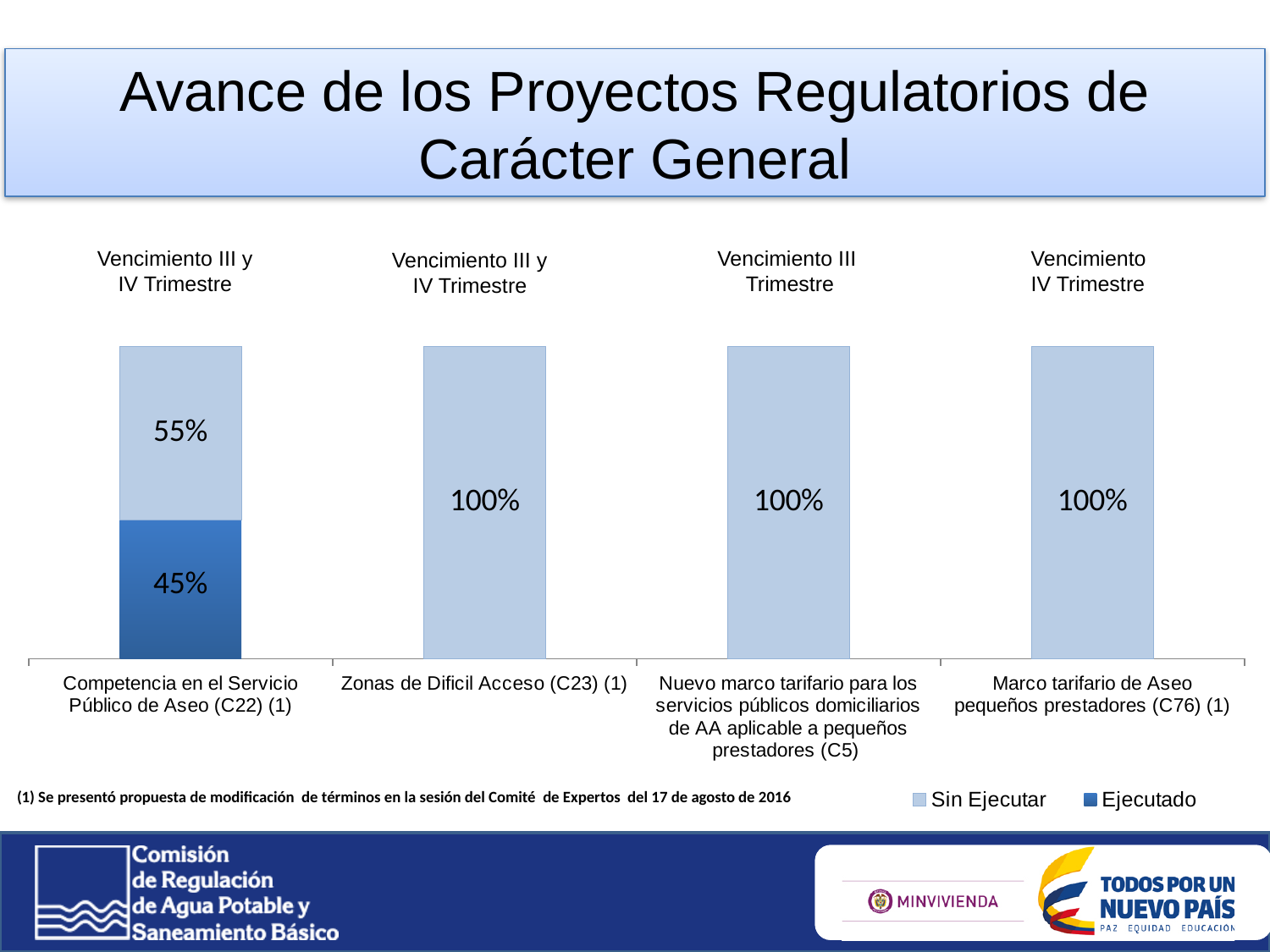
What is the Sin Ejecutar value for Zonas de Dificil Acceso (C23) (1)? 100% Which category has the highest Ejecutado value? Competencia en el Servicio Público de Aseo (C22) (1) What is the difference between the Sin Ejecutar and Ejecutado values for Competencia en el Servicio Público de Aseo (C22) (1)? 10% How many categories are plotted on the chart? 4 What kind of chart is shown on the slide? Stacked bar chart Which is larger for Competencia en el Servicio Público de Aseo (C22) (1): the Sin Ejecutar value or the Ejecutado value? Sin Ejecutar What is the Ejecutado value for Competencia en el Servicio Público de Aseo (C22) (1)? 45% How many series does the legend list? 2 What is the Sin Ejecutar value for Competencia en el Servicio Público de Aseo (C22) (1)? 55% What are the two legend entries of the chart? Sin Ejecutar and Ejecutado What is the total of the stacked bar for Competencia en el Servicio Público de Aseo (C22) (1)? 100% What is the Sin Ejecutar value for Marco tarifario de Aseo pequeños prestadores (C76) (1)? 100%